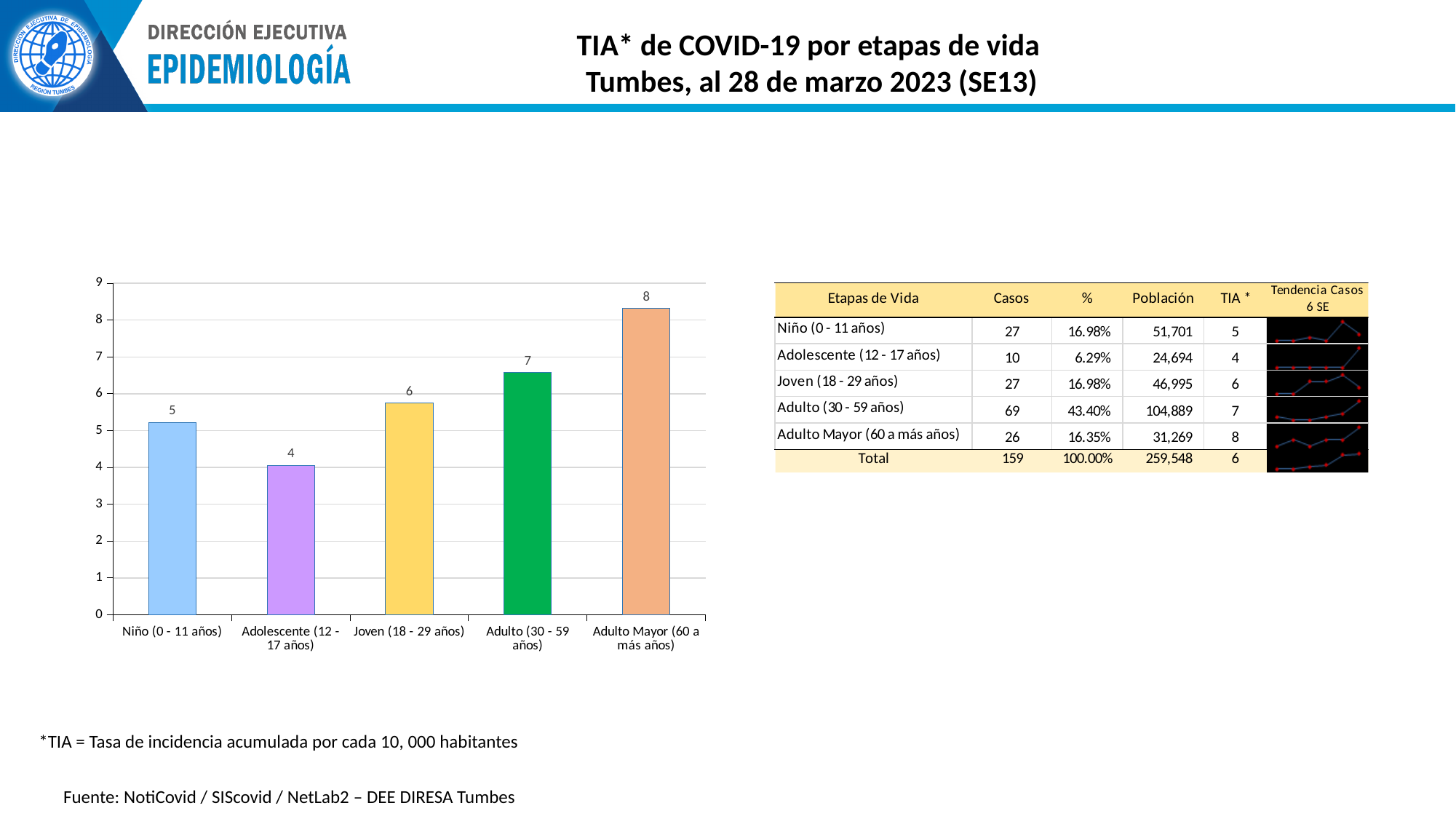
Which bar is taller: Joven (18 - 29 años) or Adulto (30 - 59 años)? Adulto (30 - 59 años) How many life-stage categories are plotted in the bar chart? 5 What is the TIA value shown for Adolescente (12 - 17 años) in the bar chart? 4 What is the TIA value shown for Adulto Mayor (60 a más años) in the bar chart? 8 Using the data labels, what is the difference between the values for Adulto Mayor (60 a más años) and Adolescente (12 - 17 años)? 4 What is the TIA value shown for Joven (18 - 29 años) in the bar chart? 6 Which life stage has the lowest bar in the chart? Adolescente (12 - 17 años) Which life stage has the highest bar in the chart? Adulto Mayor (60 a más años) What is the TIA value shown for Niño (0 - 11 años) in the bar chart? 5 What type of chart is used to show the TIA by life stage? Bar chart What is the TIA value shown for Adulto (30 - 59 años) in the bar chart? 7 Is the bar for Adulto (30 - 59 años) greater or less than 6 on the axis? greater